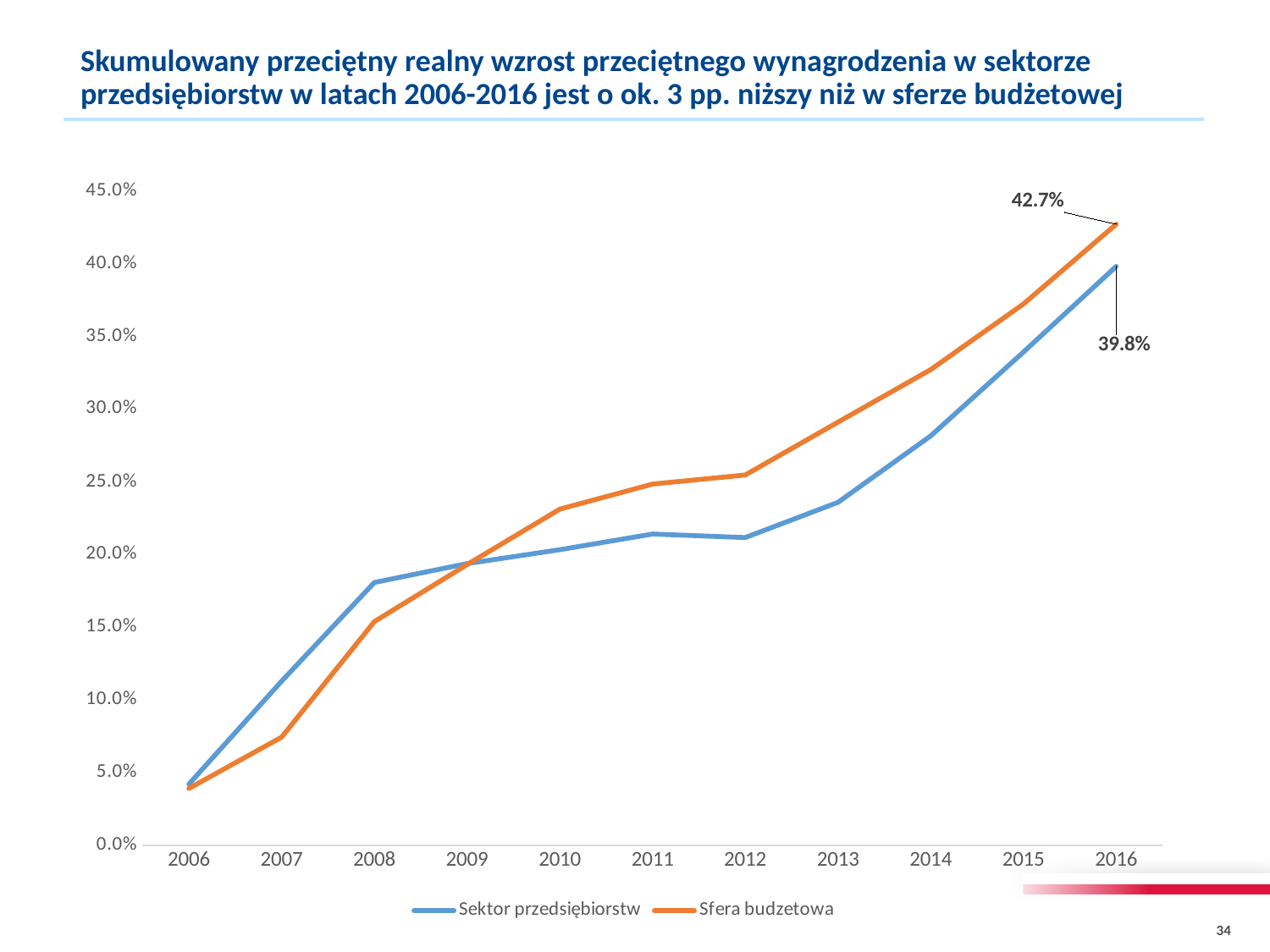
How many series does the legend list? 2 What kind of chart is shown on the slide? Line chart Is the value for Sfera budżetowa in 2014 greater or less than 30.0%? greater What is the difference between the 2016 values of Sfera budżetowa and Sektor przedsiębiorstw? 2.9 pp In 2016, which series has the higher value, Sektor przedsiębiorstw or Sfera budżetowa? Sfera budżetowa What is the value for Sektor przedsiębiorstw in 2016? 39.8% Is the value for Sektor przedsiębiorstw in 2013 greater or less than 25.0%? less What is the value for Sfera budżetowa in 2016? 42.7% In 2012, which series has the higher value, Sektor przedsiębiorstw or Sfera budżetowa? Sfera budżetowa In 2008, which series has the higher value, Sektor przedsiębiorstw or Sfera budżetowa? Sektor przedsiębiorstw How many years are shown on the x axis? 11 Is the value for Sektor przedsiębiorstw in 2008 greater or less than 15.0%? greater